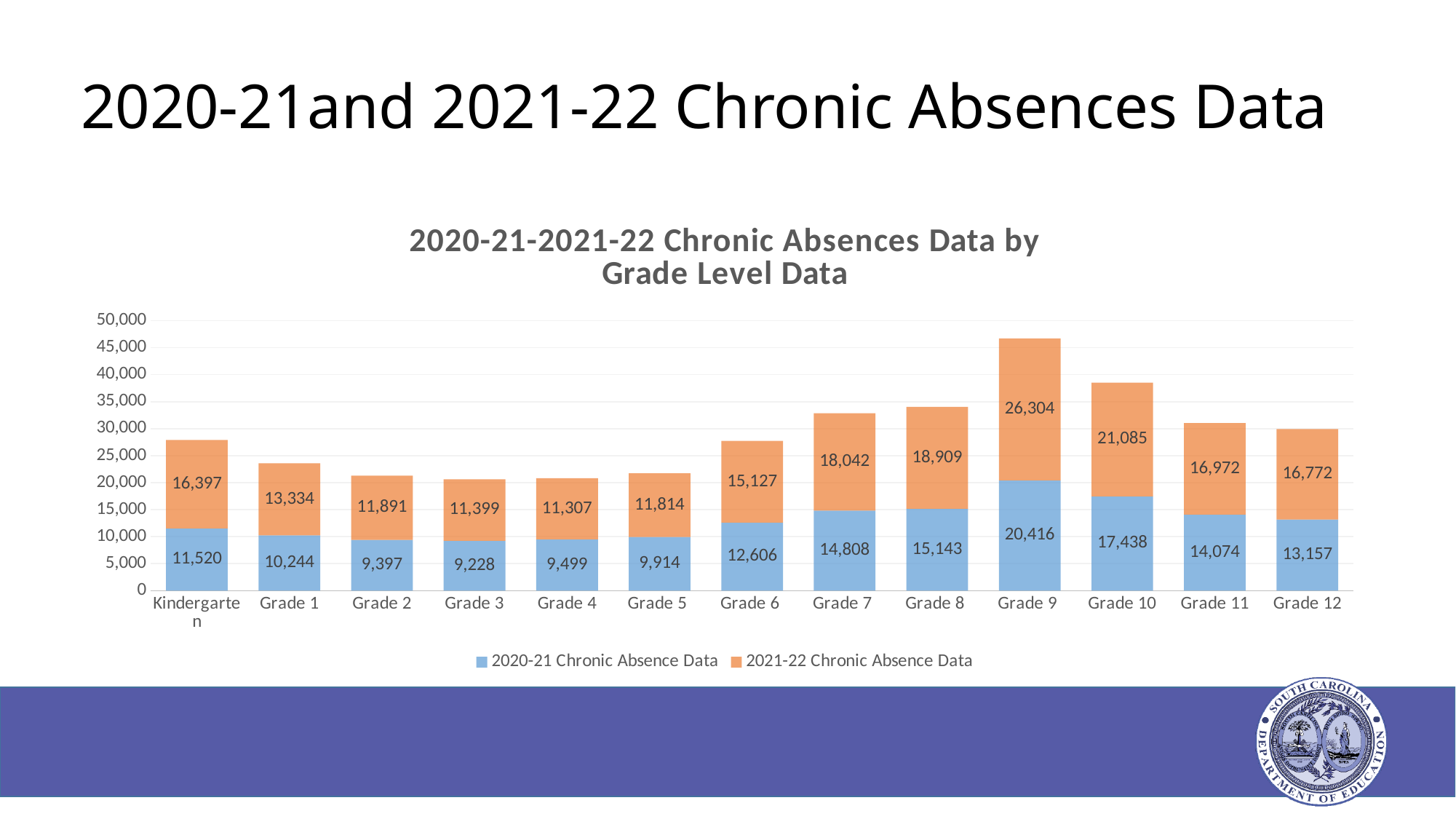
How many series does the legend list? 2 What is the total height of the stacked bar for Grade 9? 46,720 What is the difference between the 2021-22 and 2020-21 Chronic Absence Data values for Grade 9? 5,888 Which is larger: the 2020-21 Chronic Absence Data value for Grade 10 or for Grade 11? Grade 10 What is the total height of the stacked bar for Grade 3? 20,627 How many grade levels are shown on the x axis? 13 Which grade level has the lowest 2020-21 Chronic Absence Data value? Grade 3 What is the 2021-22 Chronic Absence Data value for Kindergarten? 16,397 What kind of chart is shown on the slide? Stacked bar chart What is the 2020-21 Chronic Absence Data value for Grade 9? 20,416 What is the 2021-22 Chronic Absence Data value for Grade 4? 11,307 Which grade level has the highest 2021-22 Chronic Absence Data value? Grade 9